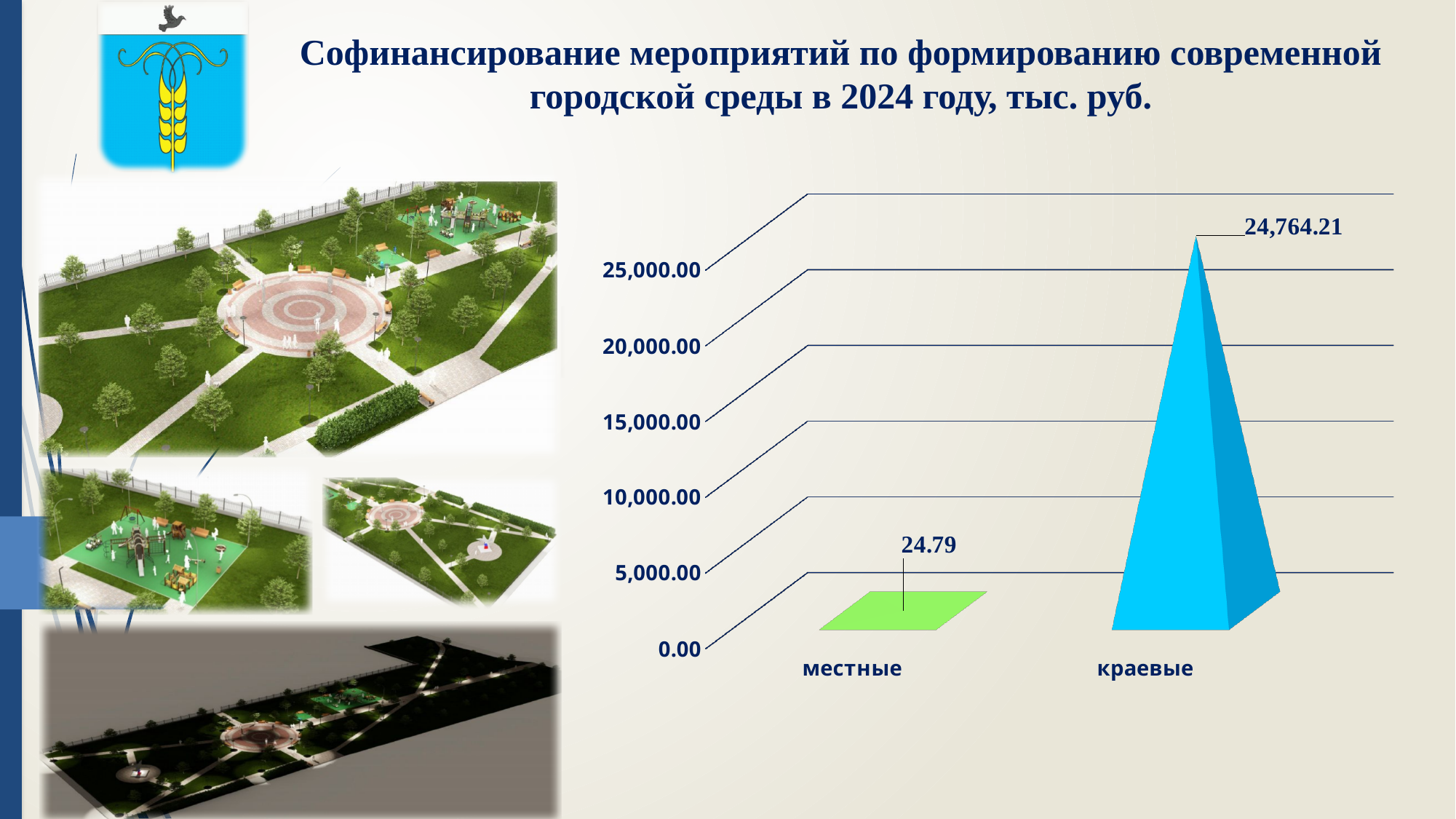
Which category has the highest value? краевые What is the highest value labelled on the vertical axis? 25,000.00 How many categories are shown on the chart? 2 What is the value for краевые? 24,764.21 What is the value for местные? 24.79 Is the value for местные greater or less than 5,000.00? less What colour is the bar for краевые? blue What kind of chart is shown on the slide? bar chart Which category has the lowest value? местные Is the value for краевые greater or less than 20,000.00? greater Which is larger, the value for местные or the value for краевые? краевые What is the difference between the values for краевые and местные? 24,739.42